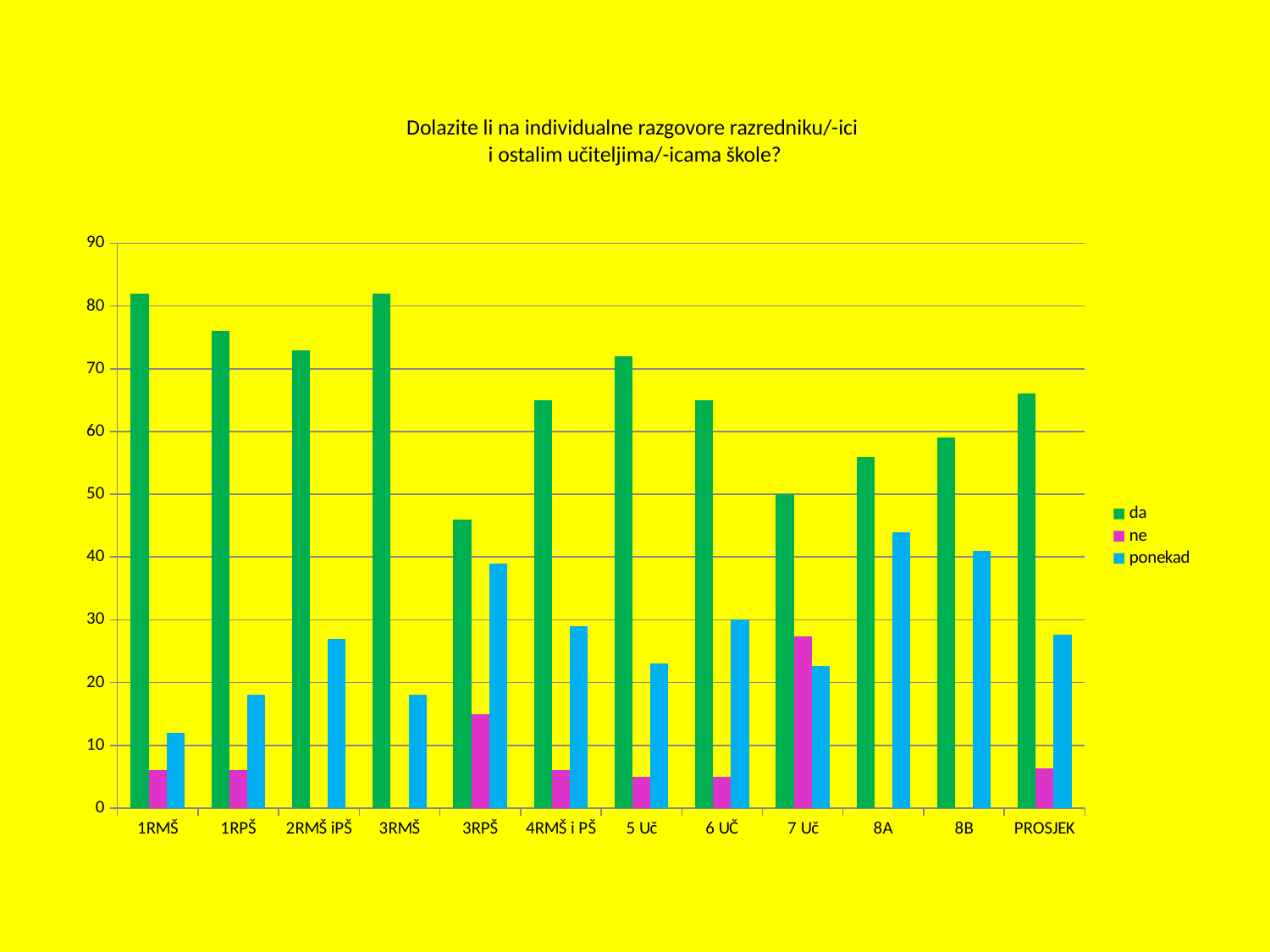
Is the "ne" value for 7 Uč greater or less than 20? greater Is the "da" value for PROSJEK greater or less than 60? greater Which category has the lowest value for the "ponekad" series? 1RMŠ Which is larger, the "da" value for 1RPŠ or the "da" value for 8B? 1RPŠ Which category has the highest value for the "ne" series? 7 Uč Which is larger, the "ponekad" value for 3RPŠ or the "ponekad" value for 5 Uč? 3RPŠ Is the "da" value for 3RPŠ greater or less than 50? less What kind of chart is shown on the slide? bar chart What are the three legend entries of the chart? da, ne, ponekad How many categories are shown on the x axis? 12 How many series does the legend list? 3